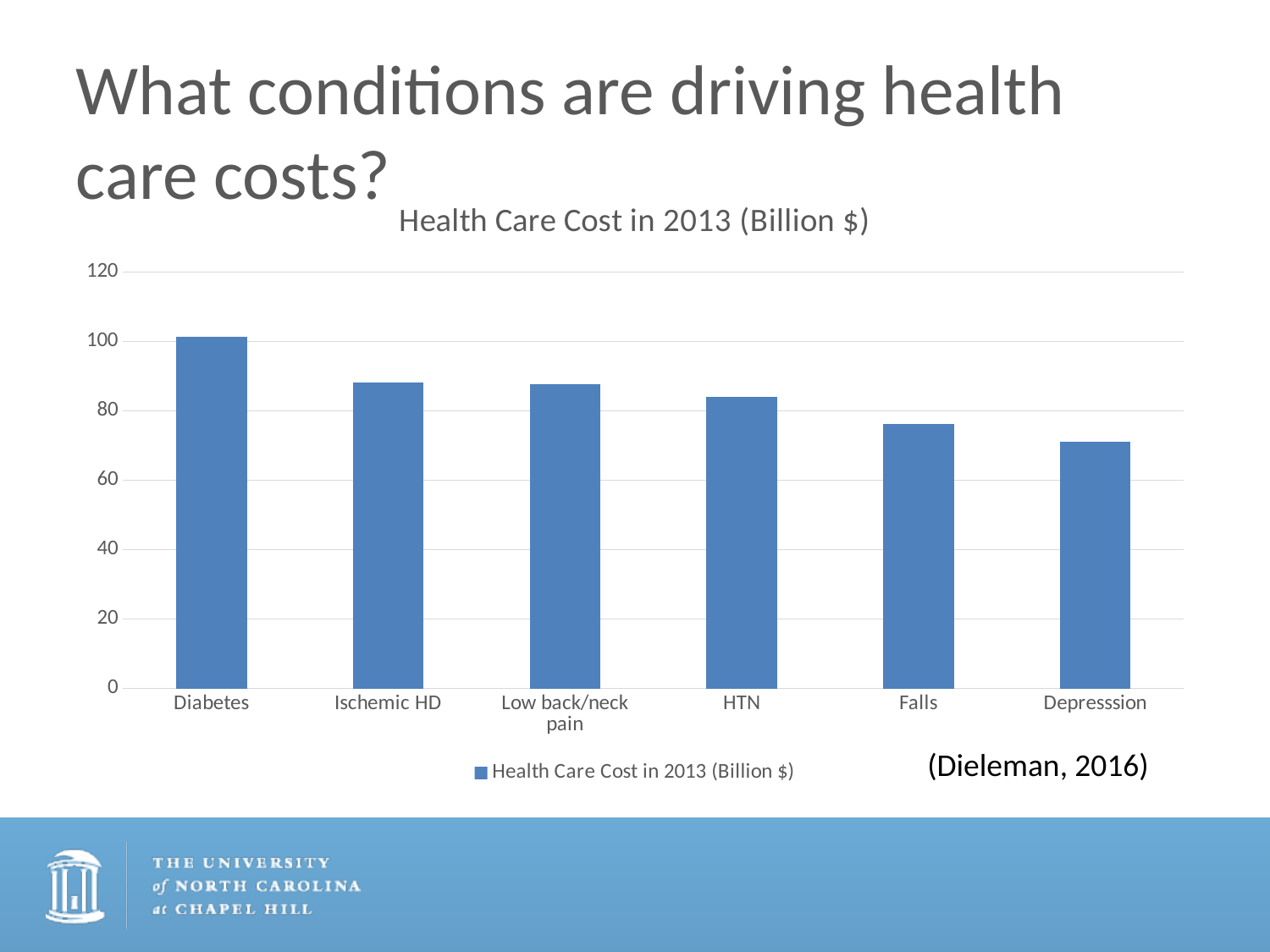
Is the value for Falls greater or less than 60? greater Is the value for Diabetes greater or less than 100? greater Which condition has the highest health care cost in 2013? Diabetes What kind of chart is shown on the slide? Bar chart What is the title of the chart? Health Care Cost in 2013 (Billion $) Do the values rise or fall moving from left to right along the x axis? Fall Is the value for Depresssion greater or less than 80? less Which is larger, the value for HTN or the value for Falls? HTN How many series does the legend list? 1 Which condition has the lowest health care cost in 2013? Depresssion What is the highest value shown on the y axis? 120 How many conditions are shown on the x axis of the chart? 6